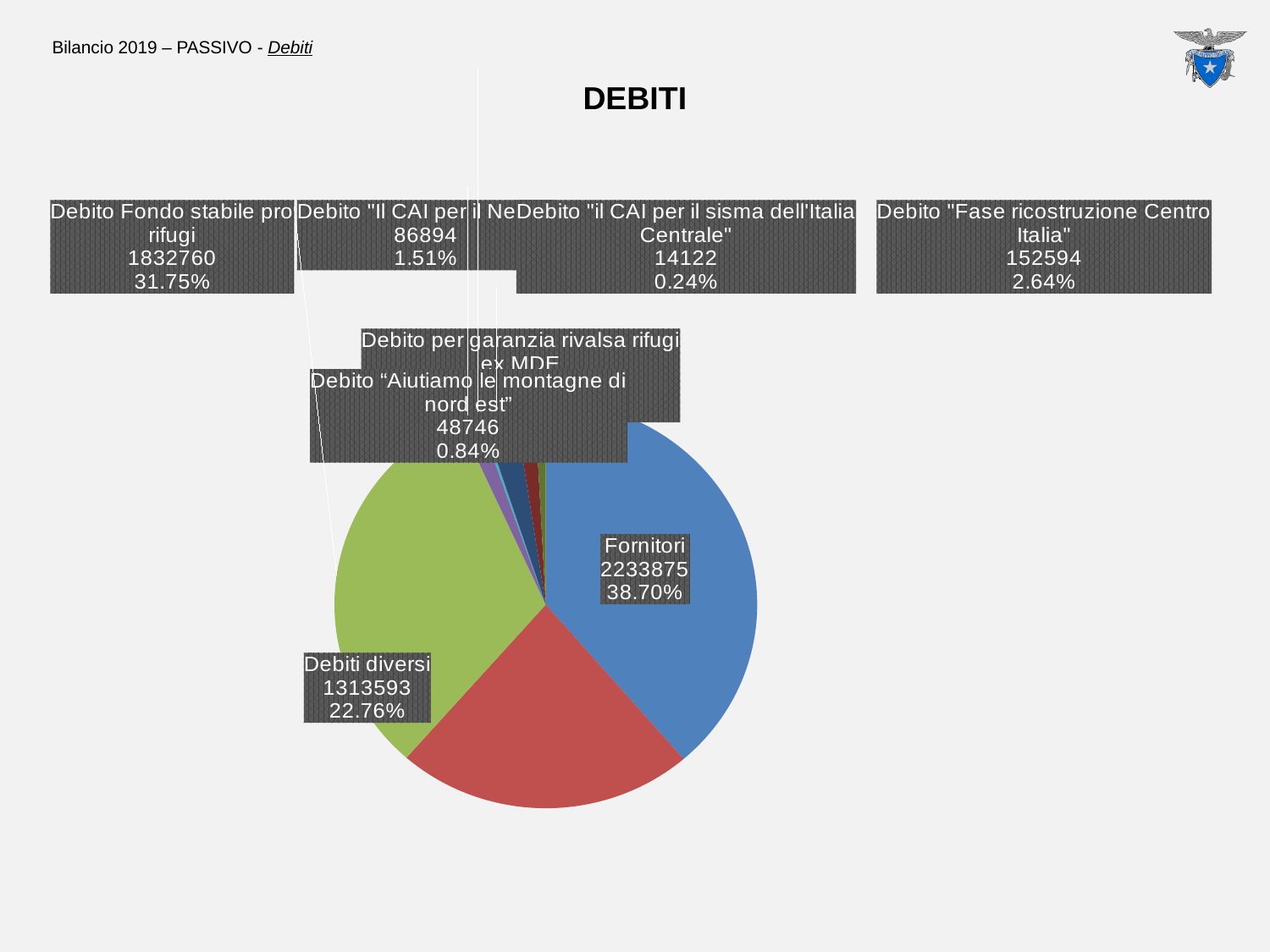
What share of the pie does Fornitori represent? 38.70% What is the title of the chart? DEBITI What share of the pie does Debito "il CAI per il sisma dell'Italia Centrale" represent? 0.24% Which is larger, Debito Fondo stabile pro rifugi or Debiti diversi? Debito Fondo stabile pro rifugi What is the value for Debito Fondo stabile pro rifugi? 1832760 Which category has the highest value? Fornitori What is the value for Debiti diversi? 1313593 What kind of chart is shown on the slide? pie chart What share of the pie does Debito "Aiutiamo le montagne di nord est" represent? 0.84% What is the value for Fornitori? 2233875 What is the difference between the values for Fornitori and Debiti diversi? 920282 What is the value for Debito "Fase ricostruzione Centro Italia"? 152594